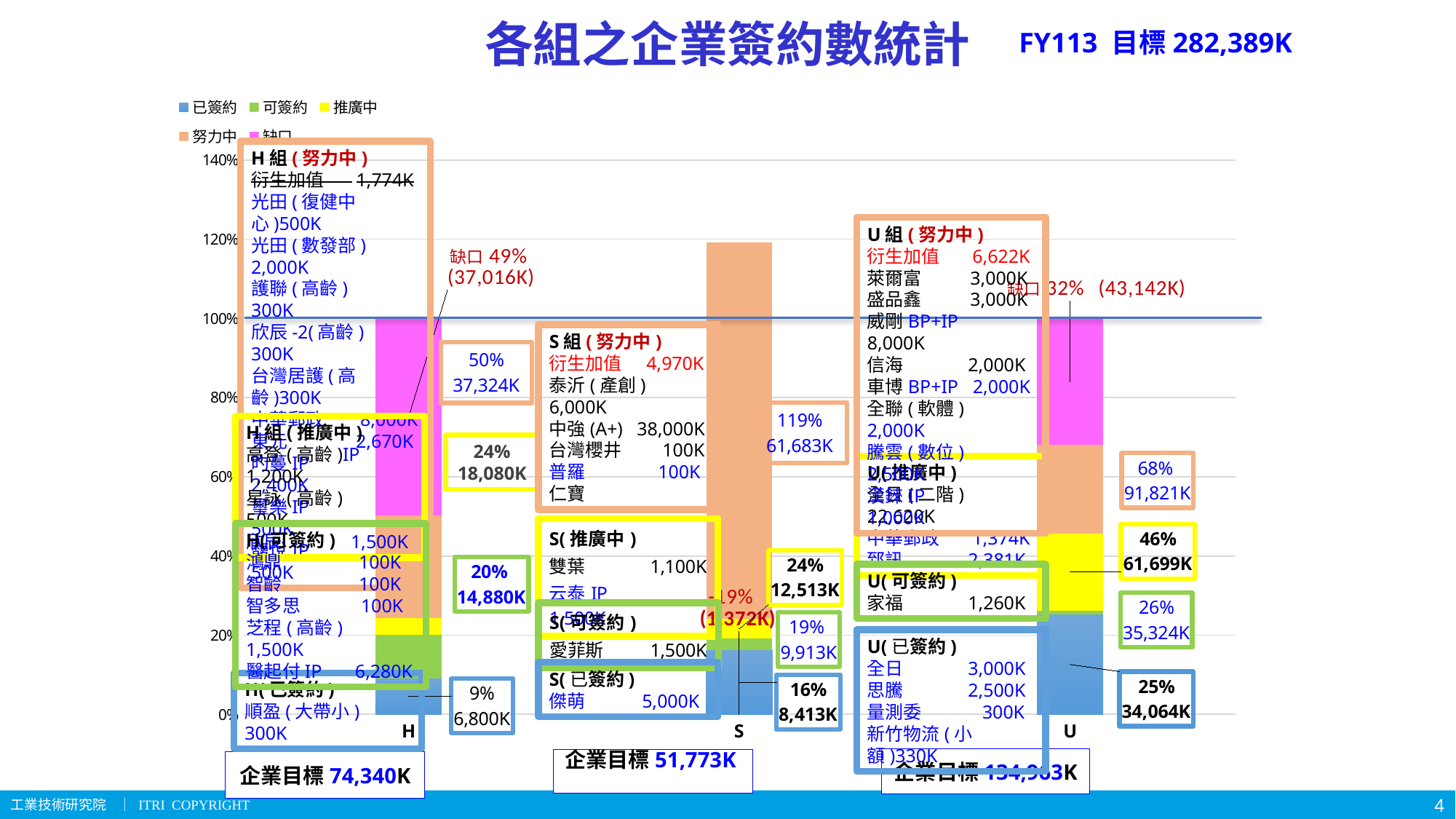
Do the 已簽約 values rise or fall going from H to S to U? rise What is the difference between the 已簽約 values of group U and group H? 27,264K Which group has the highest 已簽約 value? U What is the 努力中 value for group U? 91,821K Which is larger, the 已簽約 value for H or for S? S What percentage is shown for 推廣中 in group S? 24% What is the 已簽約 value for group H? 6,800K How many groups (categories) are plotted on the x axis? 3 What kind of chart is shown on the slide? bar chart What is the 已簽約 value for group U? 34,064K How many series does the legend list? 5 Which group has the lowest 已簽約 value? H